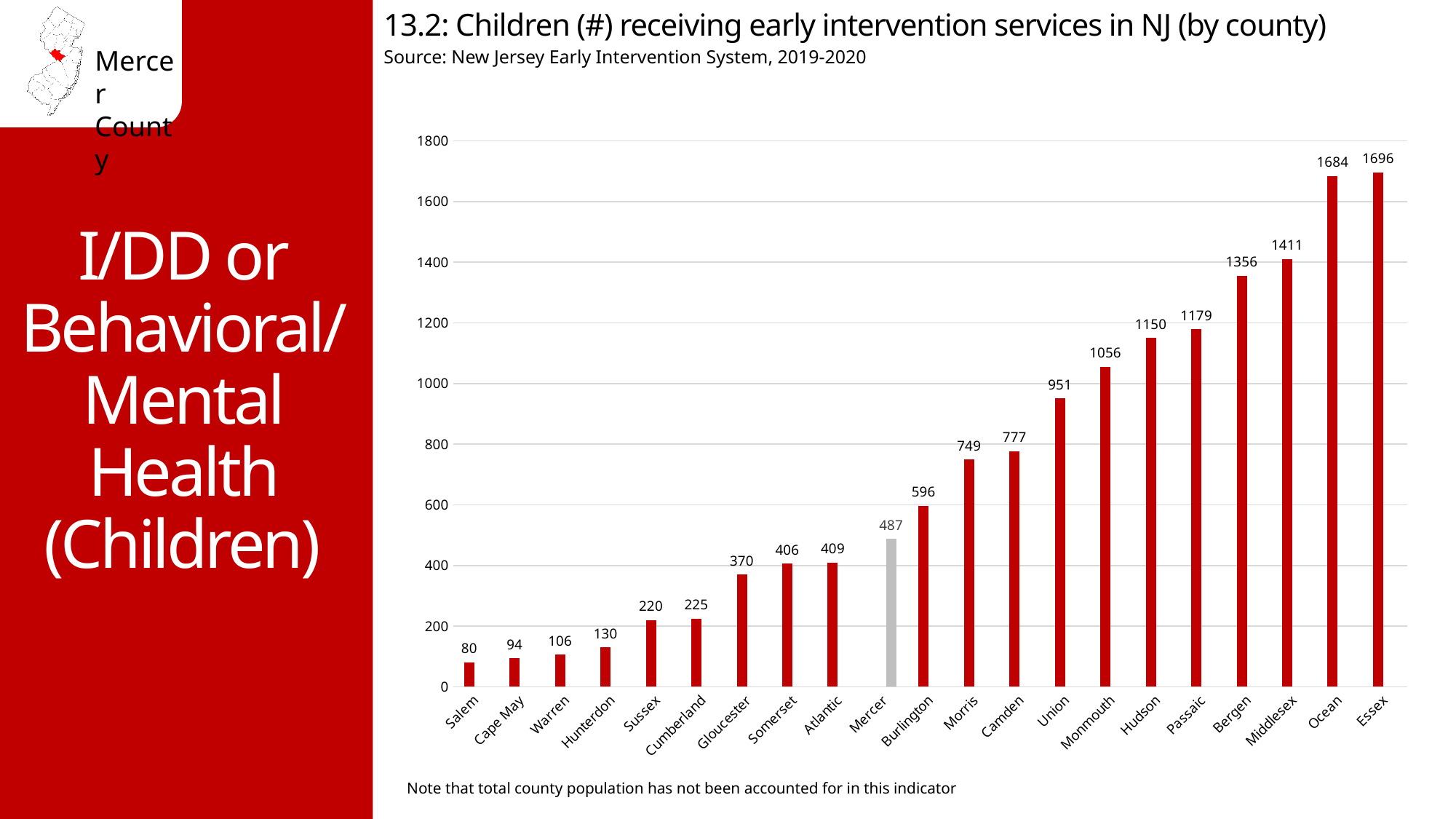
What is the value shown for Bergen County? 1356 How many counties are shown on the chart? 21 What is the difference between the values for Essex and Ocean? 12 Which county's bar is shown in grey rather than red? Mercer Is the value for Hudson greater or less than 1000? greater Which county has a larger value, Union or Camden? Union What kind of chart is shown on the slide? Bar chart Which county has the lowest number of children receiving early intervention services? Salem Do the values rise or fall moving from left to right along the x axis? Rise How many children received early intervention services in Mercer County? 487 Which county has the highest number of children receiving early intervention services? Essex What is the difference between the values for Burlington and Mercer? 109